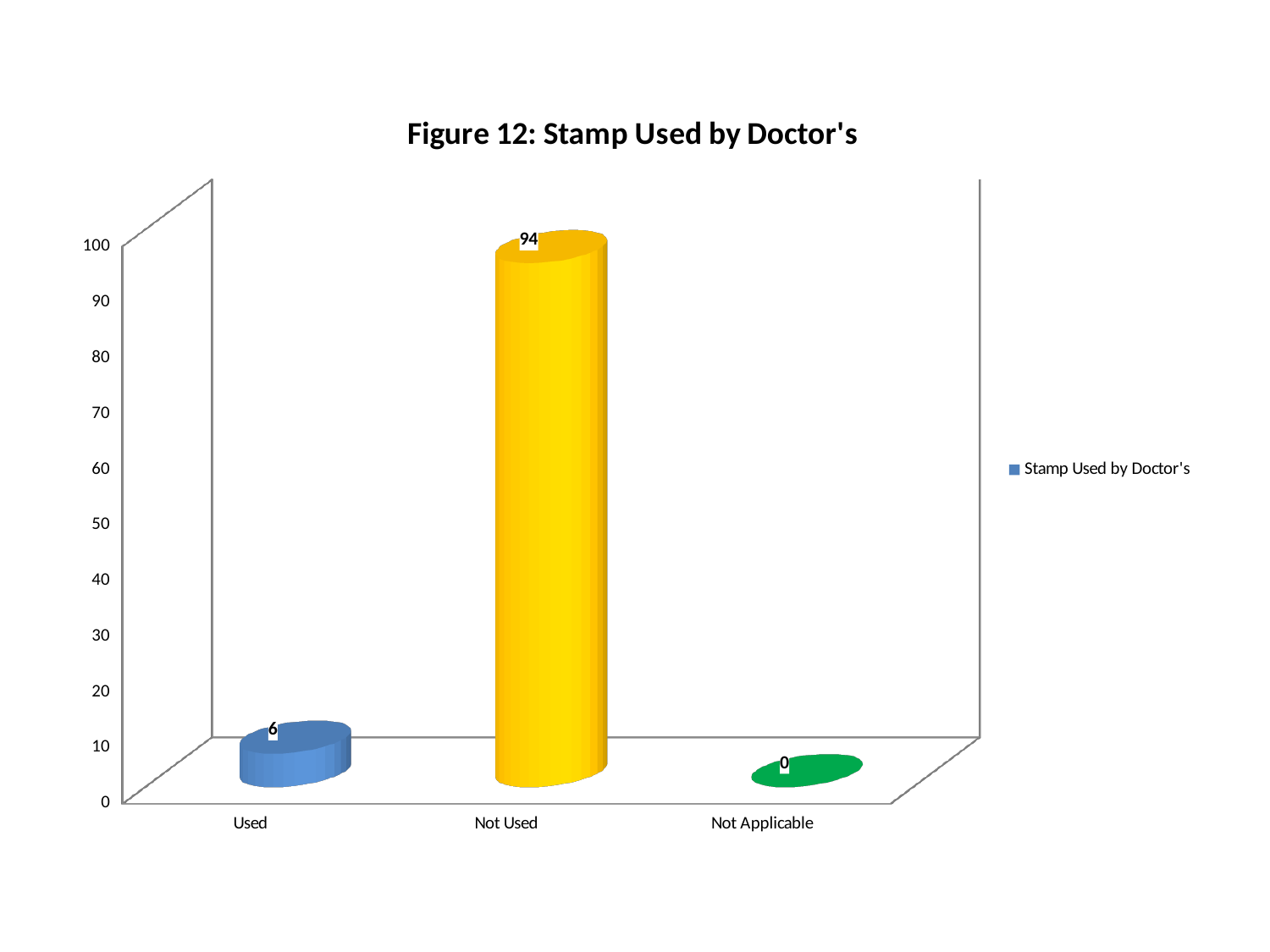
What is the value for Not Used? 94 What kind of chart is shown? bar chart Is the value for Not Used greater or less than 90? greater How many categories are shown on the x axis? 3 What is the value for Used? 6 Which category has the highest value? Not Used What is the value for Not Applicable? 0 What is the difference between the values for Not Used and Used? 88 Which is larger, the value for Used or the value for Not Used? Not Used What is the title of the chart? Figure 12: Stamp Used by Doctor's Which category has the lowest value? Not Applicable How many series does the legend list? 1